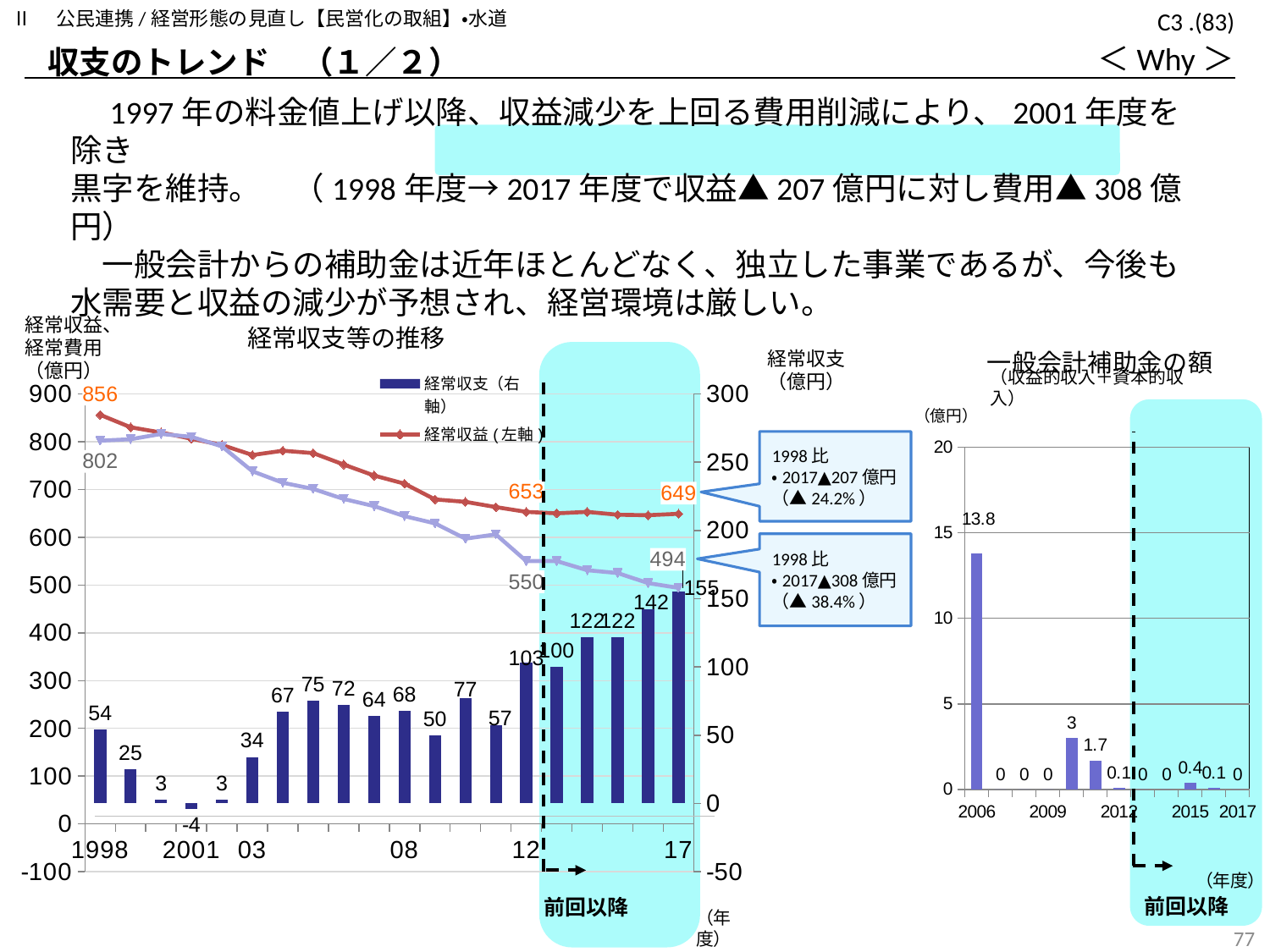
In the 一般会計補助金の額 chart on the right, which year has the highest value? 2006 In the 経常収支等の推移 chart on the left, what is the 経常収支 value for 1998? 54 What kind of chart is the 一般会計補助金の額 chart on the right? bar chart How many series does the legend of the 経常収支等の推移 chart on the left list? 2 In the 経常収支等の推移 chart on the left, what is the 経常収支 value for 2017? 155 In the 経常収支等の推移 chart on the left, by how much did 経常収益 fall from 1998 (856) to 2017 (649)? 207 In the 経常収支等の推移 chart on the left, which year has the highest 経常収支 bar? 2017 In the 経常収支等の推移 chart on the left, which is larger, the 経常収支 for 2012 or for 2016? 2016 In the 一般会計補助金の額 chart on the right, what is the value for 2010? 3 In the 経常収支等の推移 chart on the left, which year has the lowest 経常収支 bar? 2001 In the 経常収支等の推移 chart on the left, does the 経常収益 line rise or fall from 1998 to 2017? fall In the 一般会計補助金の額 chart on the right, what is the value for 2006? 13.8